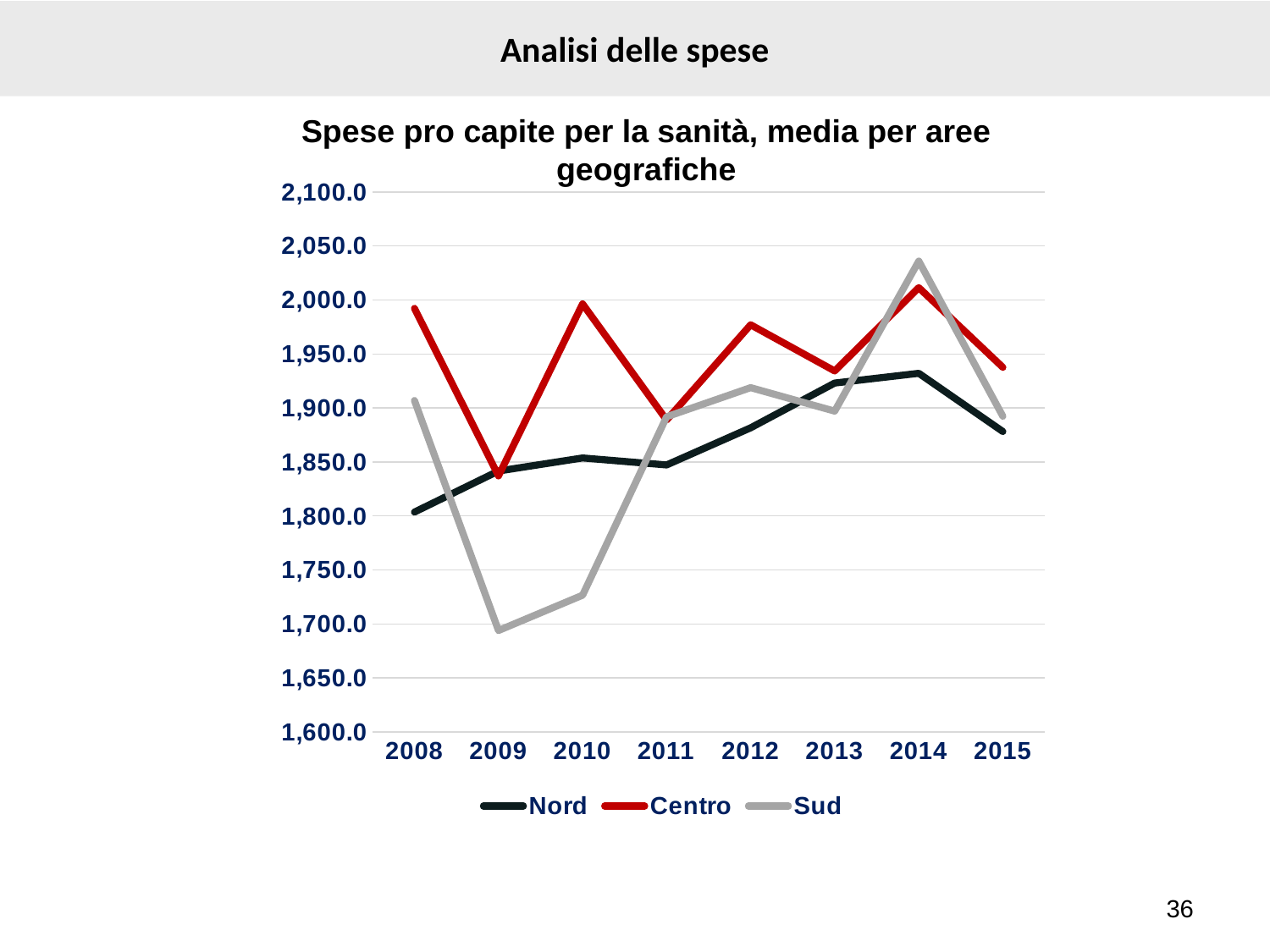
Is the value for Nord in 2008 greater or less than 1,850.0? less What type of chart is shown on the slide? line chart In 2010, which series has the larger value, Sud or Nord? Nord In which year does the Sud series reach its lowest value? 2009 Is the value for Sud in 2009 greater or less than 1,750.0? less Which series has the lowest value in 2009? Sud In which year does the Sud series reach its highest value? 2014 What colour is the Centro line in the chart? red How many series does the legend list? 3 Is the value for Sud in 2014 greater or less than 2,000.0? greater In 2008, which series has the larger value, Centro or Nord? Centro How many years are shown on the x axis? 8